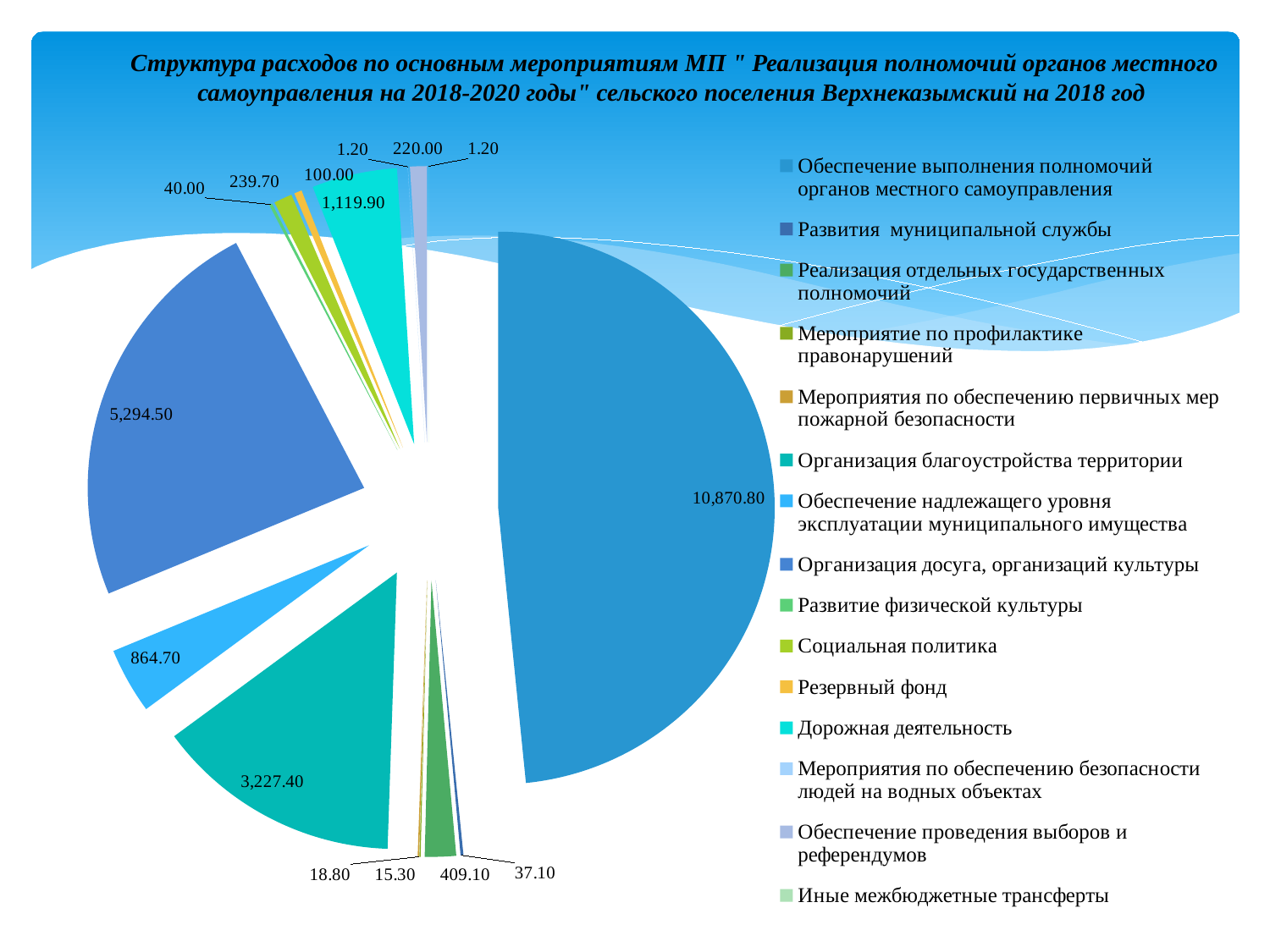
Which is larger: the slice labelled 864.70 or the slice labelled 1,119.90? 1,119.90 What is the value for Организация досуга, организаций культуры? 5,294.50 What type of chart is shown on the slide? pie chart Which category has the largest slice in the pie chart? Обеспечение выполнения полномочий органов местного самоуправления What is the difference between the slices labelled 3,227.40 and 864.70? 2,362.70 What is the value for Организация благоустройства территории? 3,227.40 What is the difference between the largest slice (10,870.80) and the slice labelled 5,294.50? 5,576.30 Which year does the chart title say the expenditure structure refers to? 2018 What is the value for Дорожная деятельность? 1,119.90 What is the value of the largest slice in the pie chart? 10,870.80 How many categories does the legend of the pie chart list? 15 What is the smallest value shown as a data label on the pie chart? 1.20